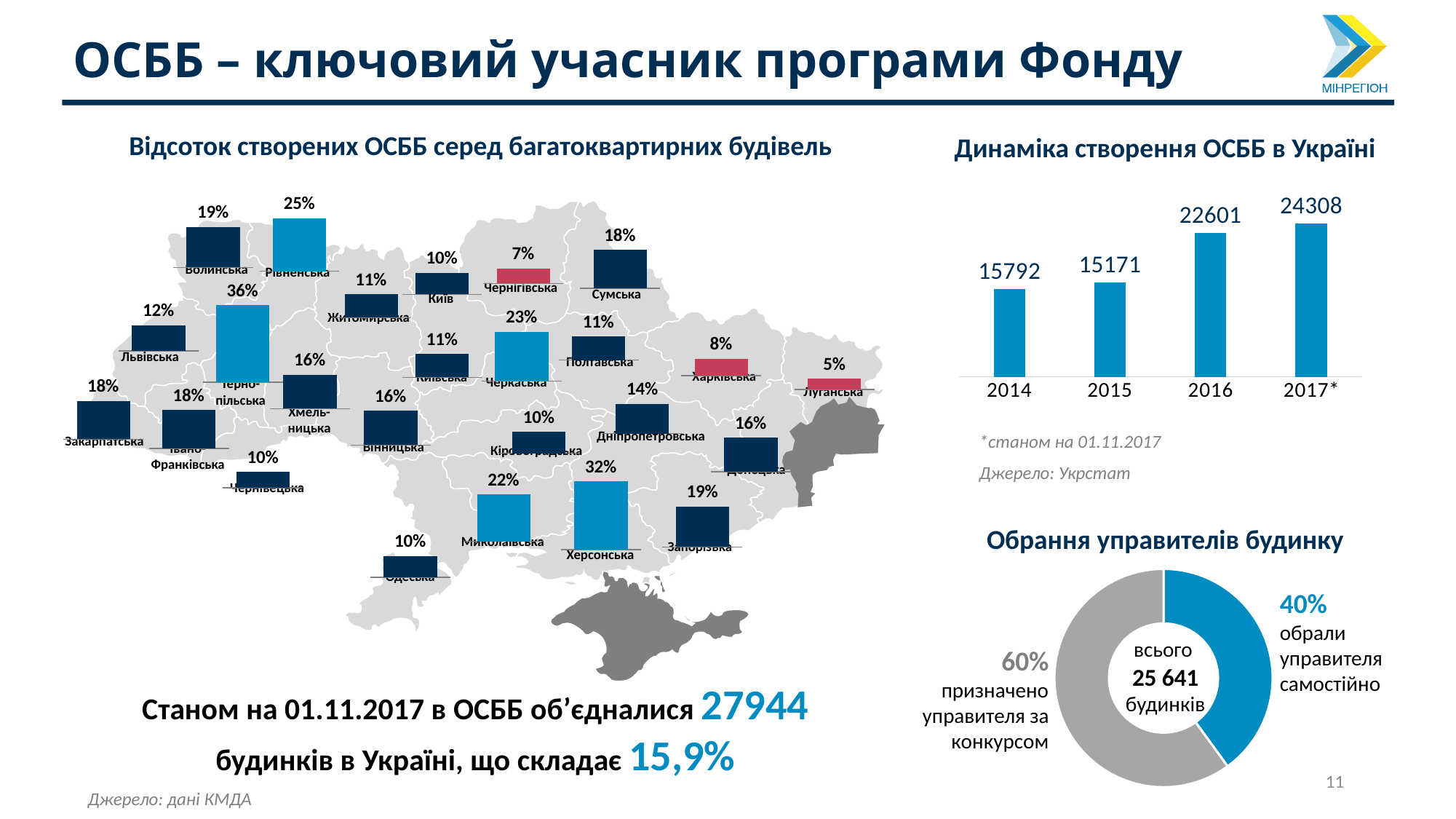
In the chart 'Динаміка створення ОСББ в Україні', which year has the lowest value? 2015 On the map 'Відсоток створених ОСББ серед багатоквартирних будівель', which region has the highest percentage? Тернопільська In the chart 'Динаміка створення ОСББ в Україні', how many years are shown on the x axis? 4 In the chart 'Динаміка створення ОСББ в Україні', which year has the highest value? 2017* In the chart 'Обрання управителів будинку', what is the total number of buildings shown in the centre? 25 641 In the chart 'Обрання управителів будинку', what share of buildings chose the manager independently (обрали управителя самостійно)? 40% In the chart 'Обрання управителів будинку', which segment is larger: 'призначено управителя за конкурсом' or 'обрали управителя самостійно'? призначено управителя за конкурсом In the chart 'Динаміка створення ОСББ в Україні', what is the difference between the 2017* and 2016 values? 1707 On the map 'Відсоток створених ОСББ серед багатоквартирних будівель', what is the percentage for Херсонська? 32% In the chart 'Динаміка створення ОСББ в Україні', what is the value for 2014? 15792 What kind of chart is 'Динаміка створення ОСББ в Україні'? bar chart In the chart 'Динаміка створення ОСББ в Україні', what is the value for 2016? 22601